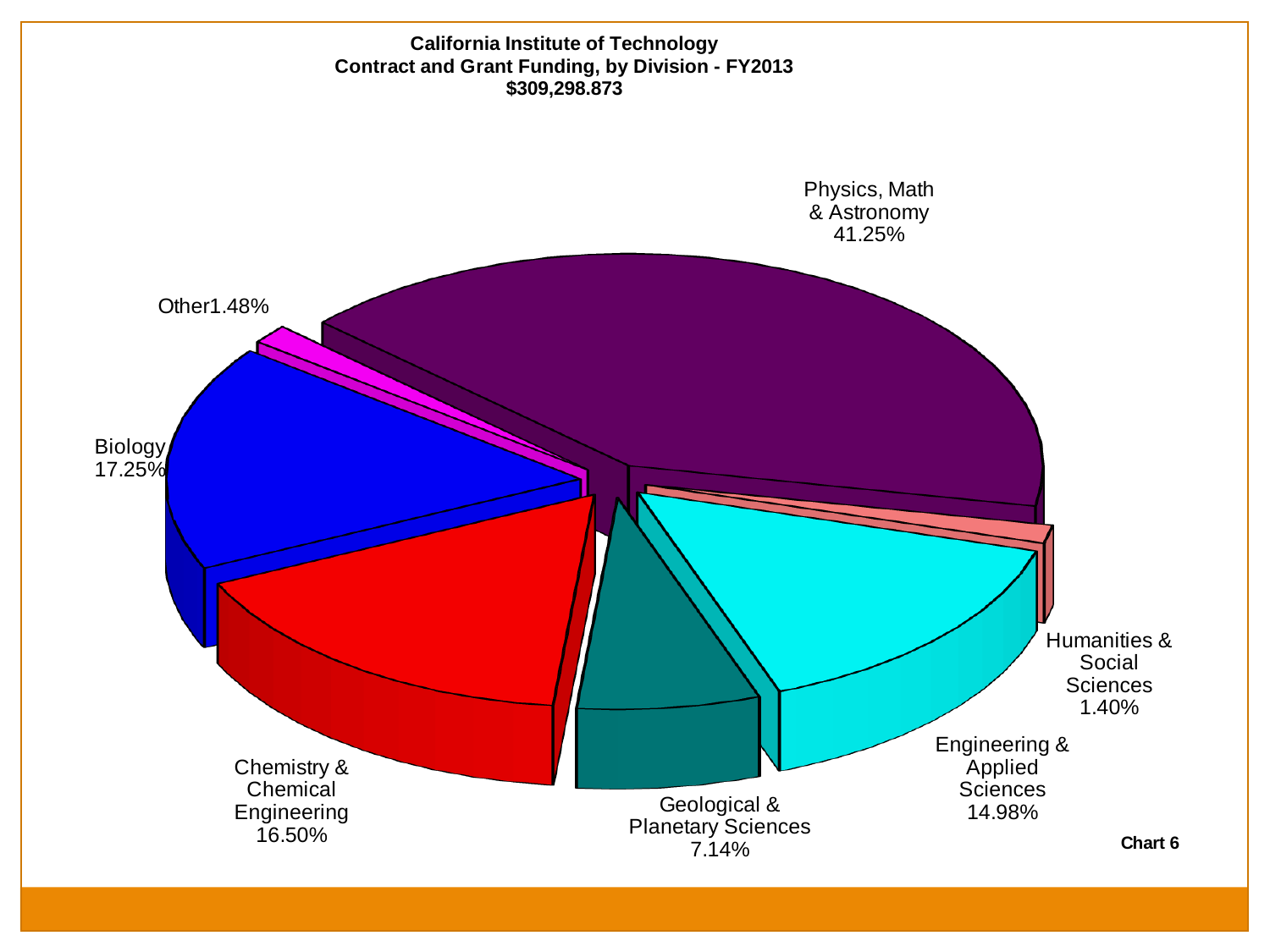
What share of contract and grant funding goes to Physics, Math & Astronomy? 41.25% What total funding amount is stated in the chart title? $309,298.873 What type of chart is shown on the slide? Pie chart What percentage is shown for Engineering & Applied Sciences? 14.98% What is the difference in percentage points between Biology and Chemistry & Chemical Engineering? 0.75 Which has a larger share, Engineering & Applied Sciences or Geological & Planetary Sciences? Engineering & Applied Sciences What percentage of funding is attributed to Biology? 17.25% What fiscal year does the chart cover? FY2013 What is the share for Geological & Planetary Sciences? 7.14% How many slices does the pie chart have? 7 Which division has the smallest share of contract and grant funding? Humanities & Social Sciences Which division has the largest share of contract and grant funding? Physics, Math & Astronomy